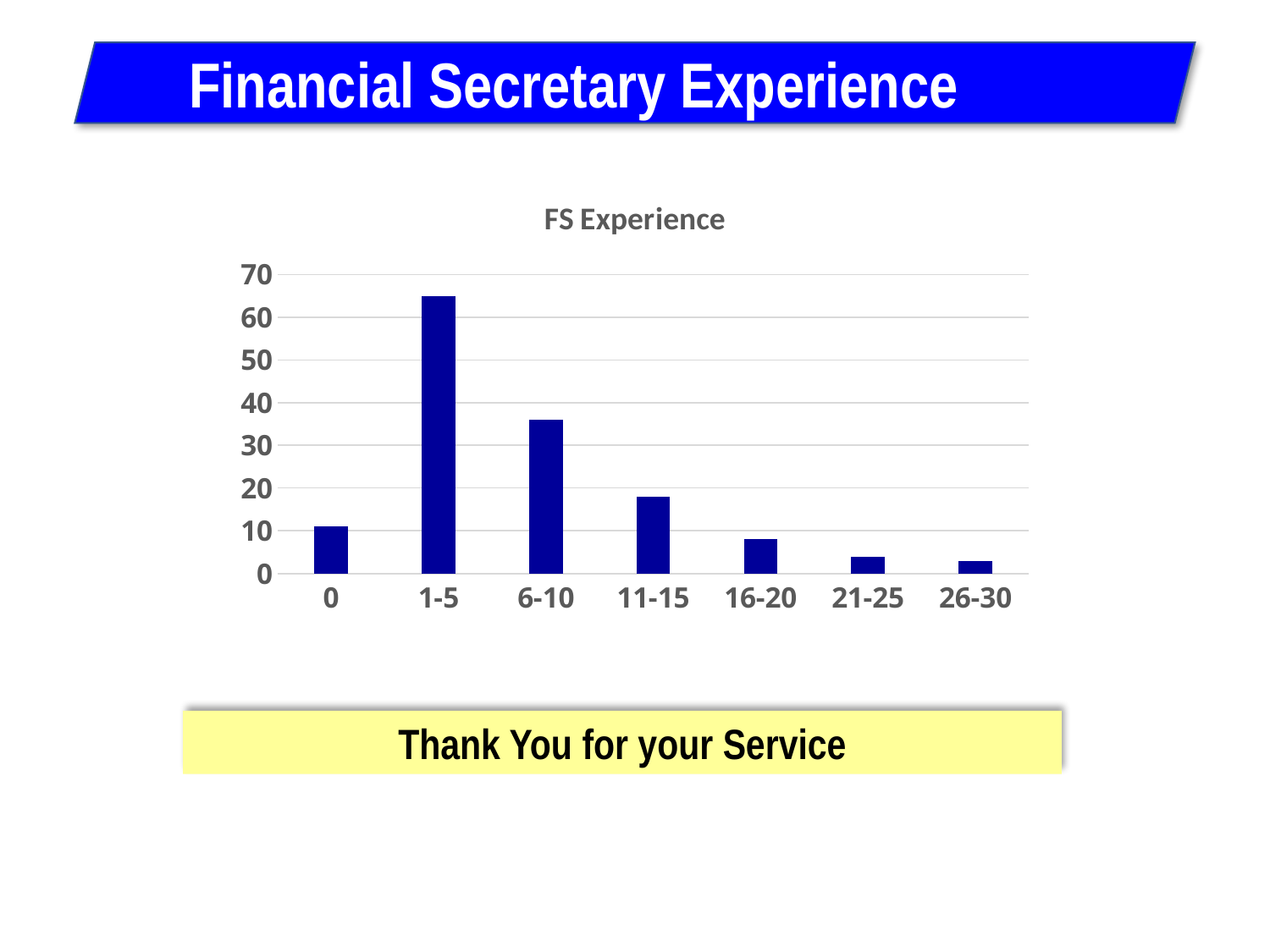
How many categories are shown on the x axis of the chart? 7 Is the value for 21-25 greater or less than 10? less Is the value for 6-10 greater or less than 30? greater What is the title of the chart? FS Experience Is the value for 11-15 greater or less than 20? less From the 1-5 category to the 26-30 category, do the values rise or fall? fall Which category has the highest value in the chart? 1-5 Which has the larger value, 0 or 16-20? 0 What kind of chart is shown on the slide? bar chart Which has the larger value, 6-10 or 11-15? 6-10